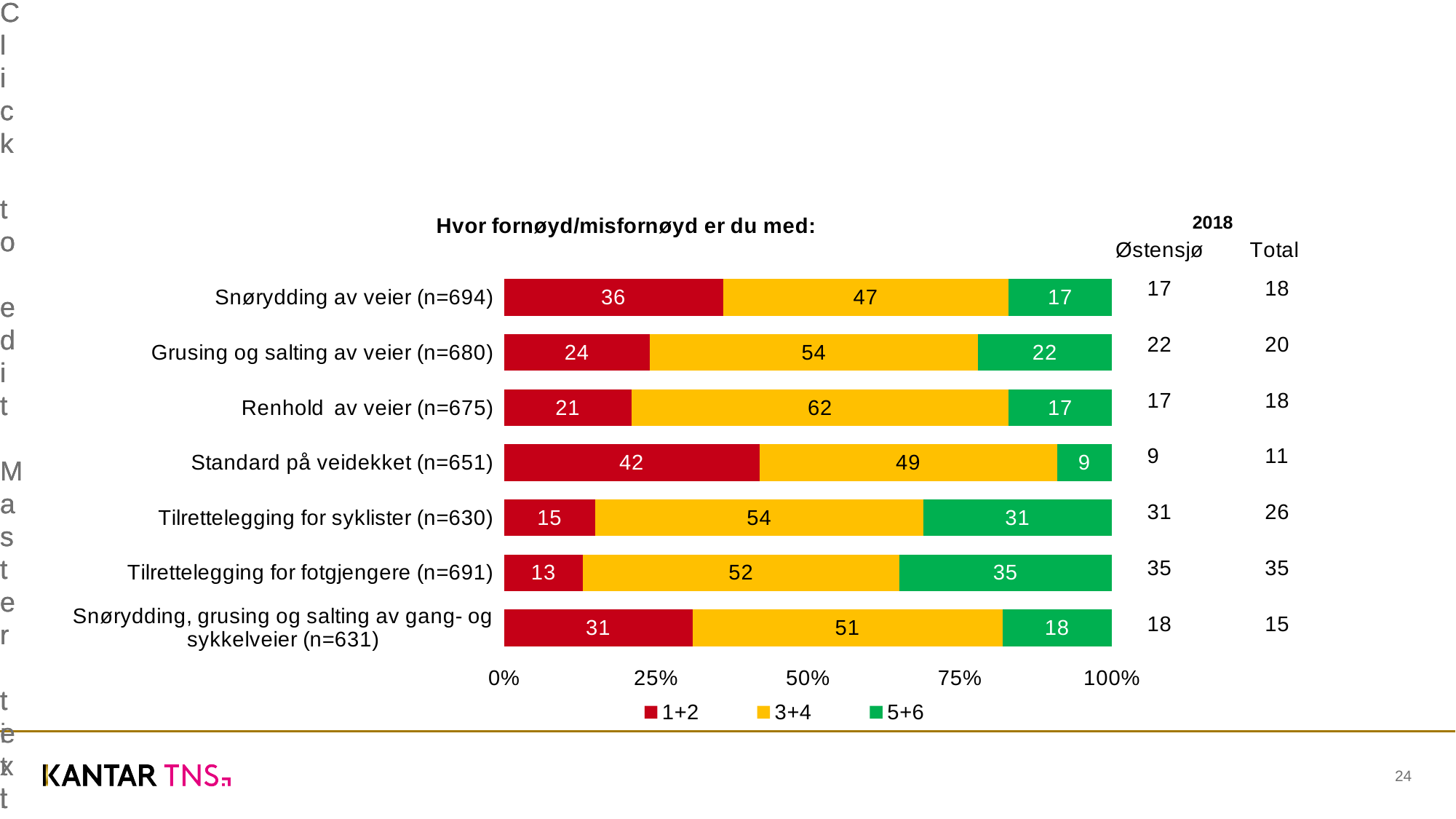
What is the value of the 5+6 series for Tilrettelegging for fotgjengere (n=691)? 35 Which is larger: the 5+6 value for Tilrettelegging for syklister (n=630) or the 5+6 value for Grusing og salting av veier (n=680)? Tilrettelegging for syklister (n=630) What kind of chart is shown on the slide? Stacked bar chart What is the value of the 1+2 series for Standard på veidekket (n=651)? 42 What is the difference between the 3+4 value and the 1+2 value for Snørydding av veier (n=694)? 11 What is the value of the 3+4 series for Renhold av veier (n=675)? 62 How many series does the legend list? 3 Which category has the lowest 5+6 value? Standard på veidekket (n=651) Which category has the highest 1+2 value? Standard på veidekket (n=651) How many categories are shown in the chart? 7 What is the total of the stacked bar for Tilrettelegging for syklister (n=630)? 100 What is the title of the chart? Hvor fornøyd/misfornøyd er du med: